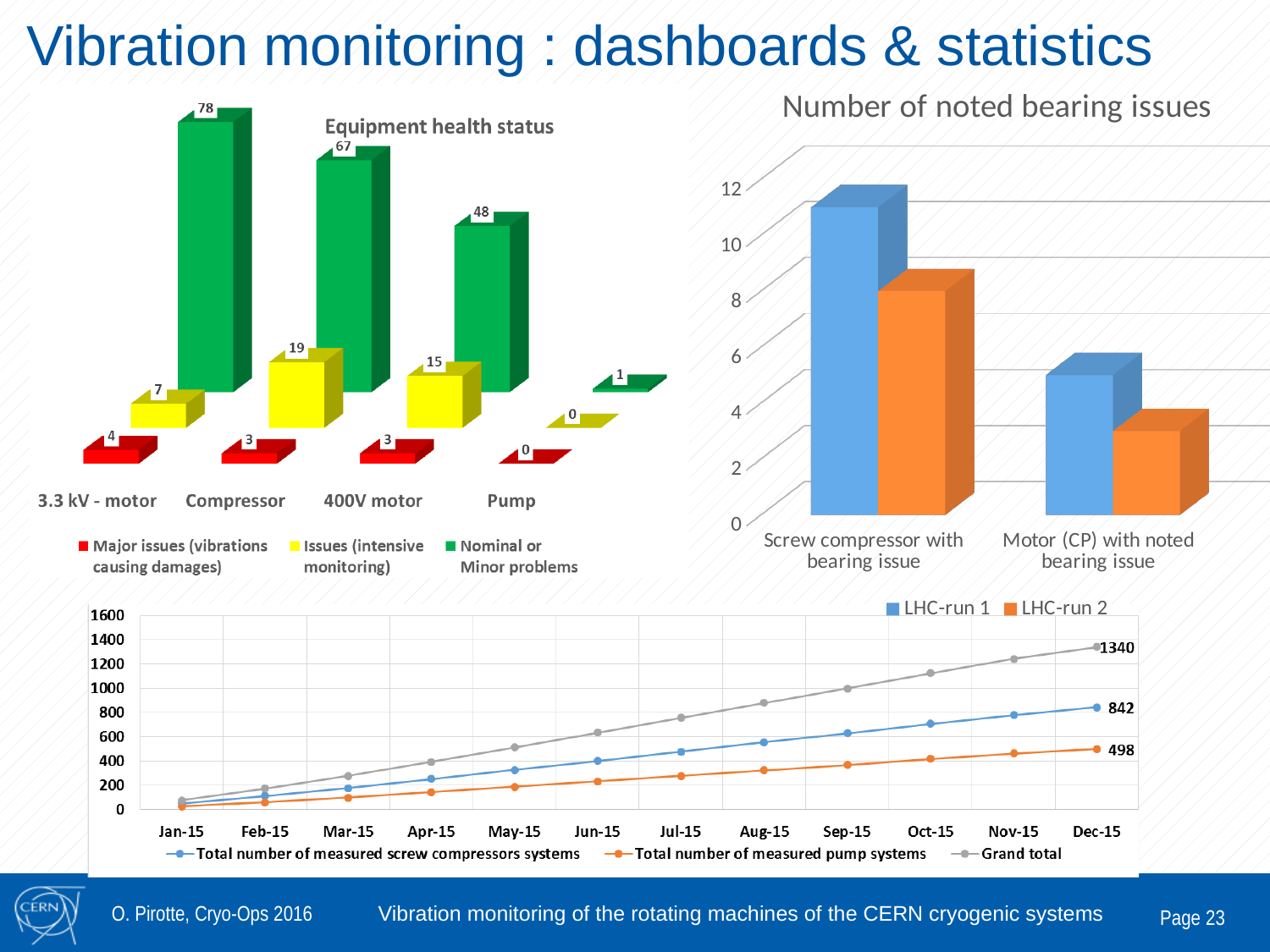
In the Number of noted bearing issues chart, which series has the larger value for Screw compressor with bearing issue, LHC-run 1 or LHC-run 2? LHC-run 1 In the bottom line chart, what is the difference between the Dec-15 values for Total number of measured screw compressors systems and Total number of measured pump systems? 344 In the Equipment health status chart, which category has the highest Nominal or Minor problems value? 3.3 kV - motor In the Equipment health status chart, what is the value for Issues (intensive monitoring) for the 400V motor category? 15 In the Equipment health status chart, what is the value for Nominal or Minor problems for the Compressor category? 67 In the Equipment health status chart, what is the difference between the Nominal or Minor problems values for 3.3 kV - motor and 400V motor? 30 In the Equipment health status chart, what is the total of all three values for the Compressor category? 89 In the Number of noted bearing issues chart, is the LHC-run 2 value for Motor (CP) with noted bearing issue greater or less than 4? less In the Number of noted bearing issues chart, is the LHC-run 1 value for Screw compressor with bearing issue greater or less than 10? greater In the bottom line chart, what is the Grand total value at Dec-15? 1340 In the Equipment health status chart, how many series does the legend list? 3 In the bottom line chart, how many months are shown on the x axis? 12